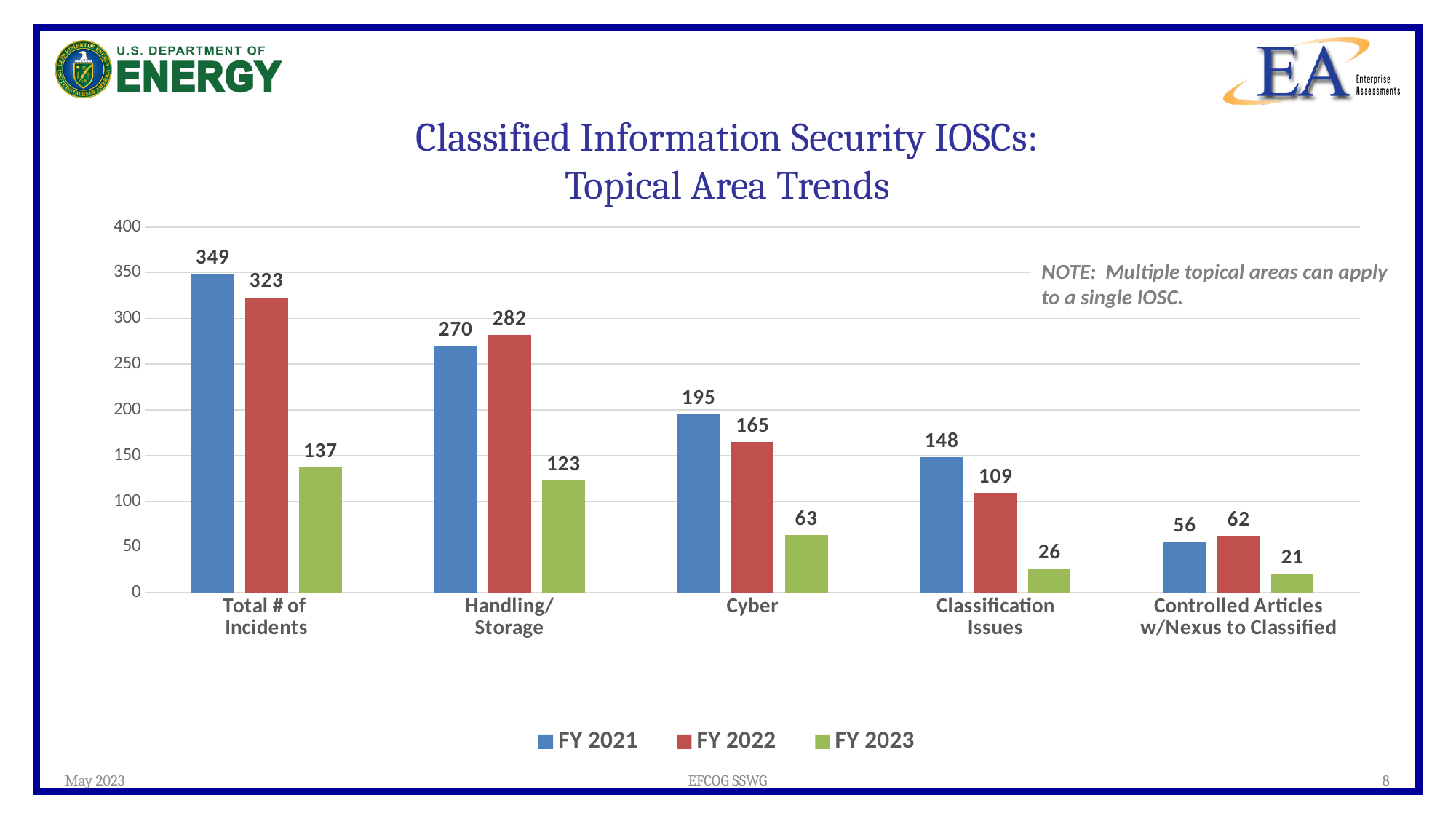
What is the FY 2022 value for Handling/Storage? 282 Which is larger for Controlled Articles w/Nexus to Classified: the FY 2021 value or the FY 2022 value? FY 2022 What is the FY 2021 value for Classification Issues? 148 Which category has the highest FY 2023 value? Total # of Incidents How many categories are shown on the x axis? 5 What is the FY 2023 value for Cyber? 63 Is the FY 2022 value for Cyber greater or less than 150? greater Do the FY 2021 values rise or fall from Total # of Incidents to Controlled Articles w/Nexus to Classified? Fall How many series does the legend list? 3 Which category has the lowest FY 2021 value? Controlled Articles w/Nexus to Classified What is the difference between the FY 2021 and FY 2022 values for Total # of Incidents? 26 What kind of chart is shown on the slide? Bar chart